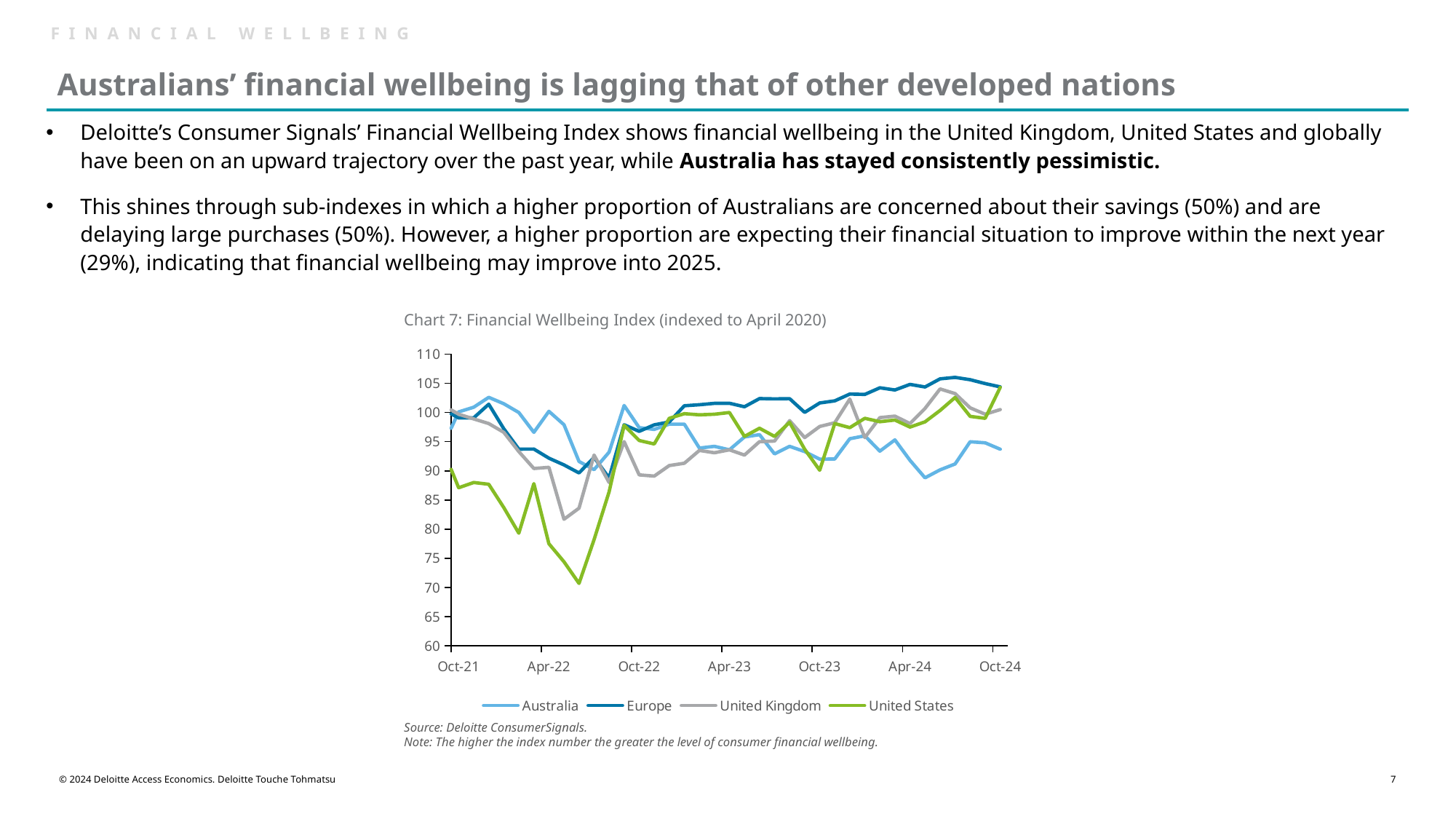
At Apr-22 in Chart 7, which is higher: Australia or United States? Australia Is the value for Australia at Oct-24 in Chart 7 greater or less than 100? less Does the Europe series in Chart 7 generally rise or fall between Oct-22 and Oct-24? rise What is the title of the chart on the slide? Chart 7: Financial Wellbeing Index (indexed to April 2020) Is the value for Europe at Oct-24 in Chart 7 greater or less than 100? greater Which series in Chart 7 has the lowest value at Oct-24? Australia How many series does the legend of Chart 7 list? 4 Is the lowest value of the United States series in Chart 7 greater or less than 75? less What kind of chart is Chart 7? Line chart Which series in Chart 7 is shown in green? United States Which series in Chart 7 falls to the lowest value at any point on the chart? United States At Oct-24 in Chart 7, which is higher: Europe or Australia? Europe